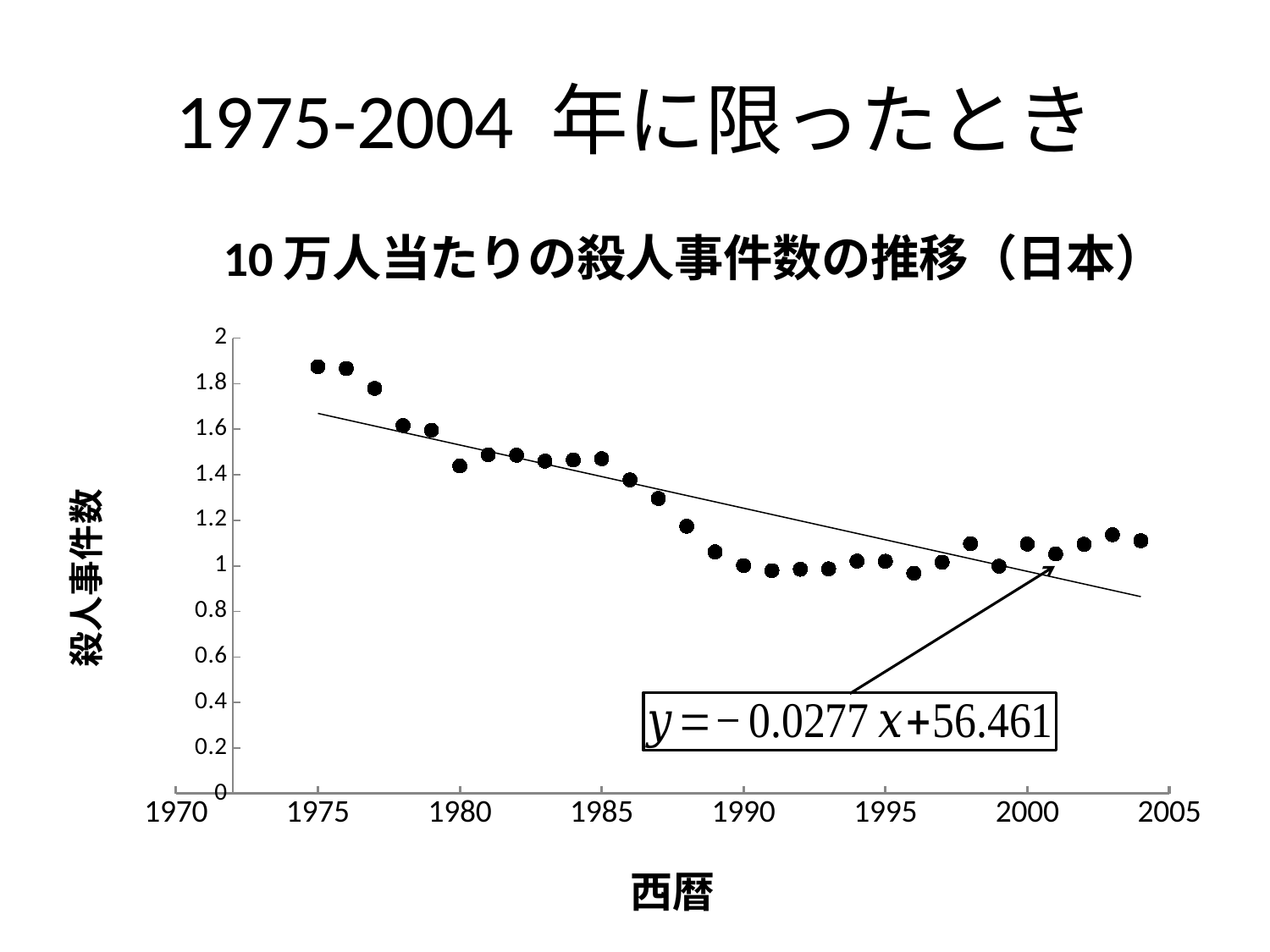
Is the value for 1980 greater or less than 1.6? less Which year has the larger value, 1975 or 2004? 1975 Overall, do the plotted values rise or fall from 1975 to 2004? fall Is the value for 1975 greater or less than 1.6? greater Is the value for 1985 greater or less than 1.2? greater What kind of chart is shown on the slide? scatter chart Which year has the larger value, 1977 or 1978? 1977 What is the equation of the trend line shown on the chart? y = −0.0277x + 56.461 What is the title of the chart? 10万人当たりの殺人事件数の推移（日本） How many data points are plotted on the chart? 30